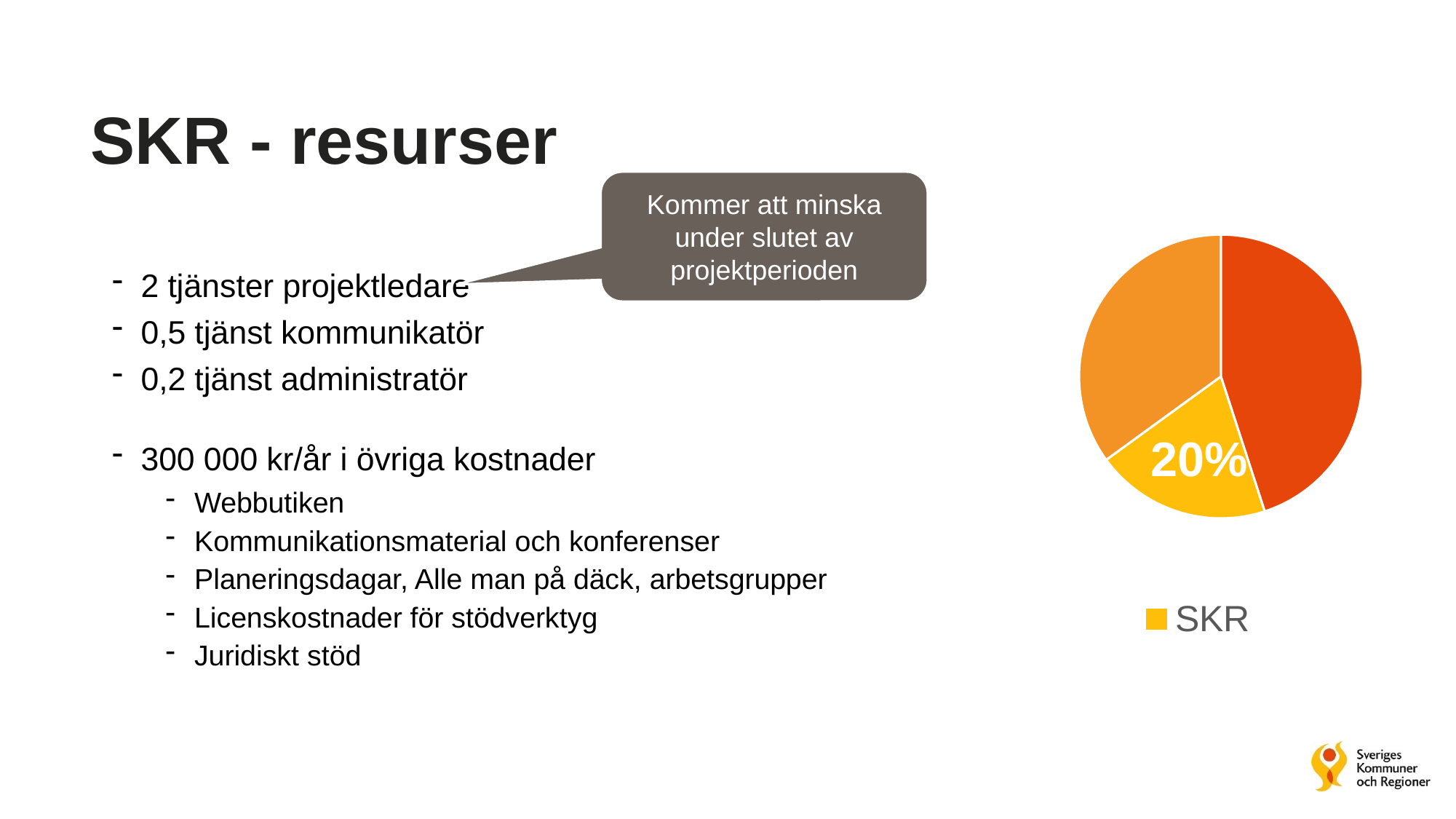
What is the only entry shown in the pie chart's legend? SKR What kind of chart is shown on the slide? pie chart Is the SKR slice larger or smaller than the red-orange slice? smaller Is the SKR slice the largest slice of the pie chart? No Which slice is the smallest in the pie chart? SKR (20%) What share of the pie does the SKR slice represent? 20% What value is printed on the yellow slice of the pie chart? 20% What colour is the SKR slice in the pie chart? yellow How many slices does the pie chart have? 3 How many entries does the legend of the pie chart list? 1